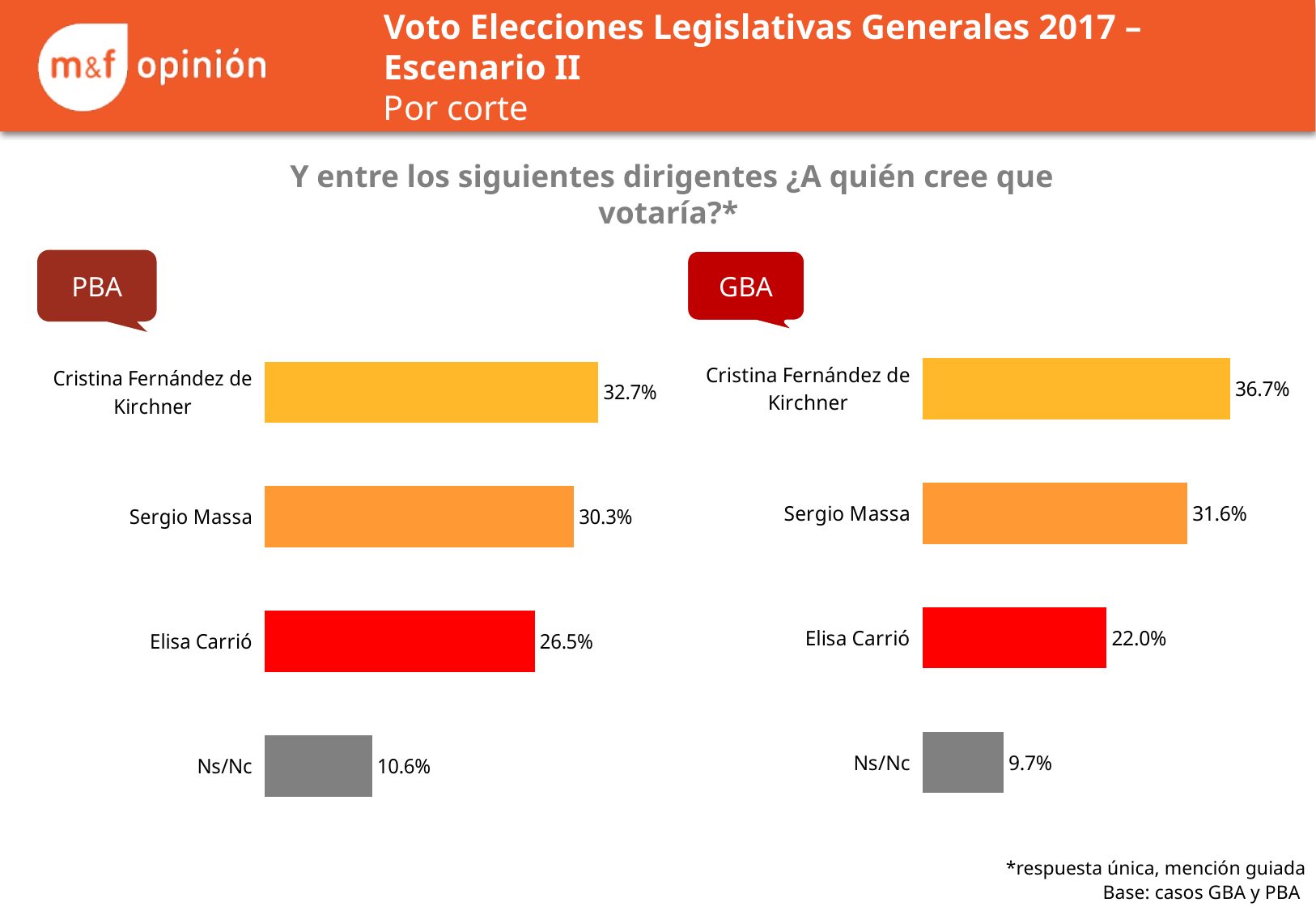
In the GBA chart, what percentage is shown for Sergio Massa? 31.6% In the PBA chart, what percentage is shown for Ns/Nc? 10.6% How many categories does the GBA chart show? 4 In the PBA chart, what percentage is shown for Cristina Fernández de Kirchner? 32.7% In the PBA chart, what colour is the bar for Elisa Carrió? Red What type of chart is the PBA chart? Bar chart In the GBA chart, what is the difference between Cristina Fernández de Kirchner and Sergio Massa? 5.1% In the PBA chart, which category has the lowest value? Ns/Nc In the PBA chart, what is the difference between Cristina Fernández de Kirchner and Elisa Carrió? 6.2% Is Elisa Carrió's value higher in the PBA chart or the GBA chart? PBA In the GBA chart, which category has the highest value? Cristina Fernández de Kirchner In the GBA chart, what percentage is shown for Elisa Carrió? 22.0%